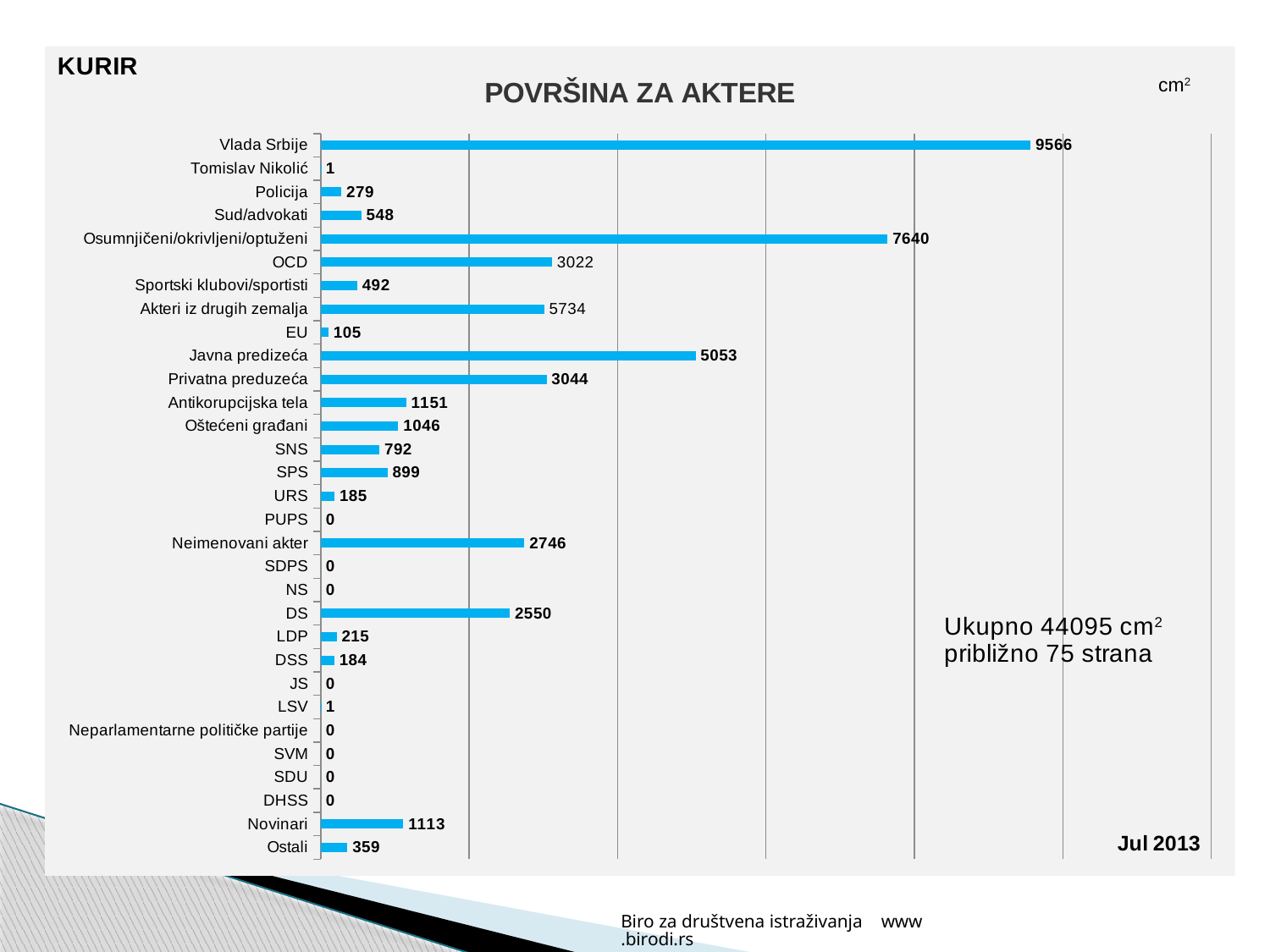
What is the value for Vlada Srbije? 9566 What is the title of the chart? POVRŠINA ZA AKTERE What is the value for Novinari? 1113 What is the value for Osumnjičeni/okrivljeni/optuženi? 7640 What kind of chart is shown on the slide? Bar chart Which is larger, the value for DS or the value for Neimenovani akter? Neimenovani akter How many categories are shown on the chart? 31 Which category has the highest value? Vlada Srbije What is the value for Javna predizeća? 5053 What is the difference between the values for Vlada Srbije and Osumnjičeni/okrivljeni/optuženi? 1926 What is the difference between the values for SPS and SNS? 107